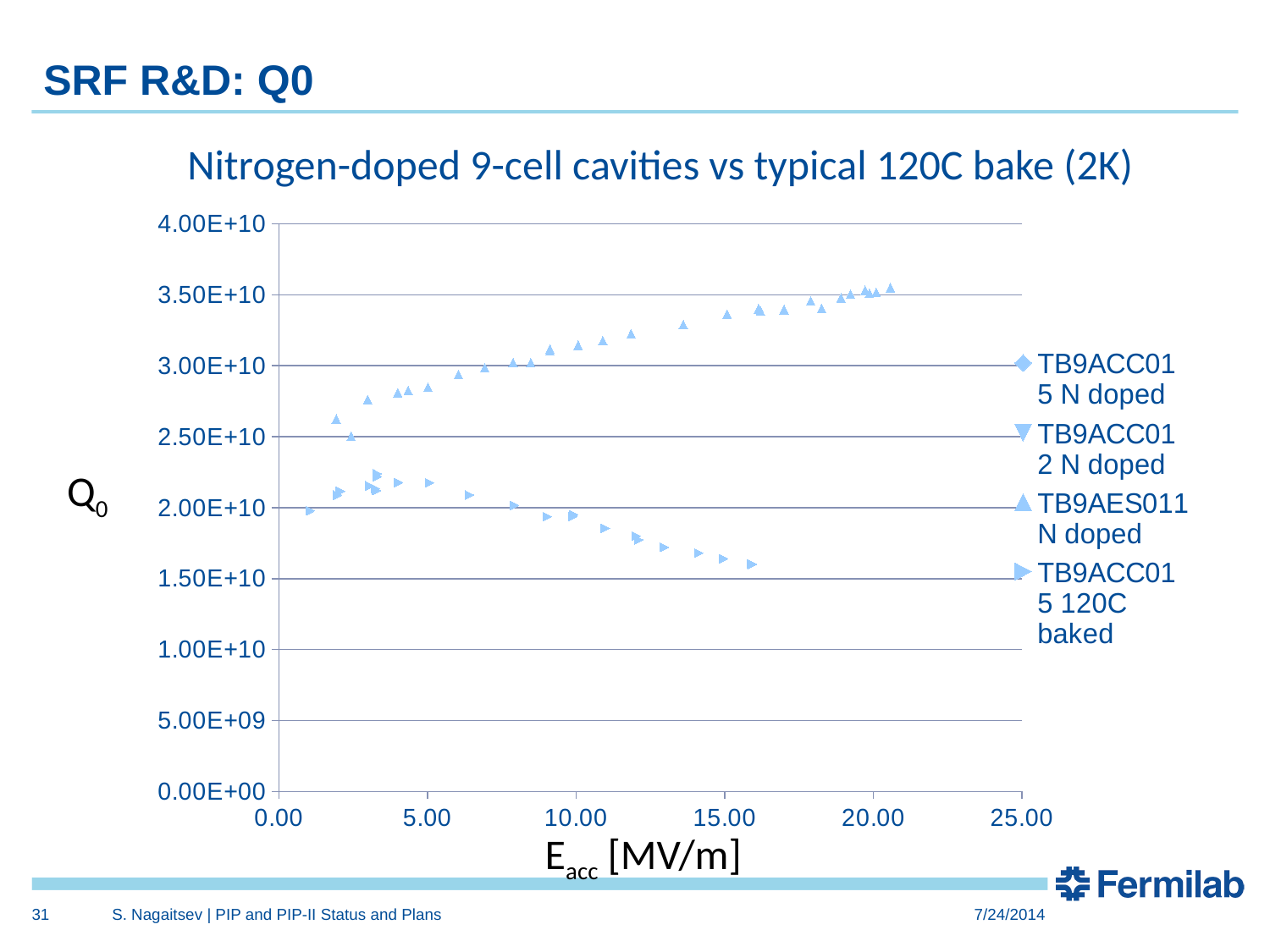
Is the Q0 value for the TB9AES011 N doped series at 20 MV/m greater or less than 3.00E+10? greater At 10 MV/m, which series has the higher Q0: TB9AES011 N doped or TB9ACC015 120C baked? TB9AES011 N doped What is the title of the chart? Nitrogen-doped 9-cell cavities vs typical 120C bake (2K) What is the label of the x axis? Eacc [MV/m] Do the values for the TB9AES011 N doped series rise or fall as Eacc increases? rise Do the values for the TB9ACC015 120C baked series rise or fall as Eacc increases beyond 5 MV/m? fall What kind of chart is shown on the slide? scatter chart Which series has the lowest Q0 value on the chart? TB9ACC015 120C baked How many series does the legend list? 4 Is the Q0 value for the TB9ACC015 120C baked series at 15 MV/m greater or less than 2.00E+10? less Which series reaches the highest Q0 value on the chart? TB9AES011 N doped Is the Q0 value for the TB9AES011 N doped series at 5 MV/m greater or less than 2.50E+10? greater